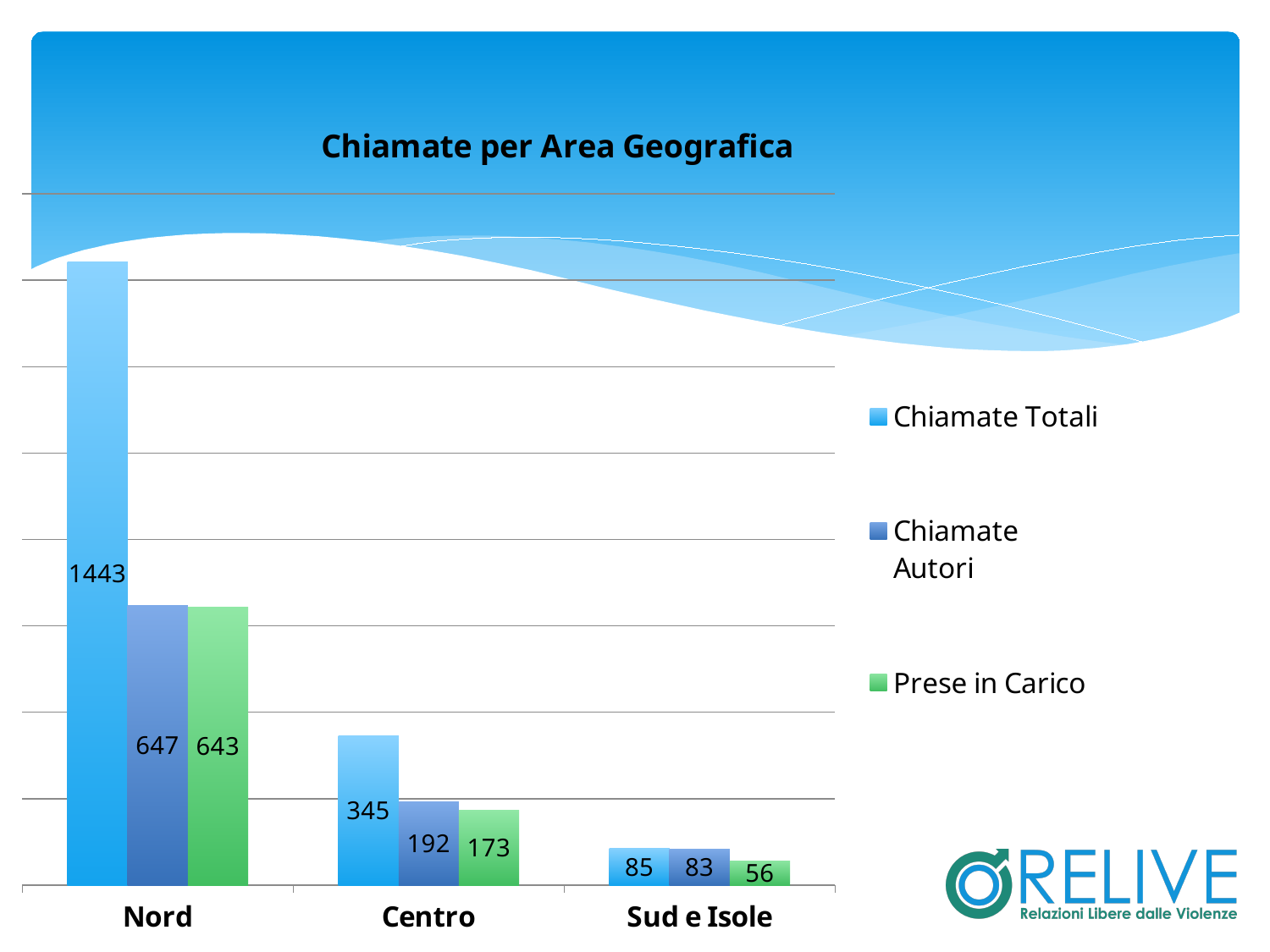
How many series does the legend list? 3 What is the value of Chiamate Totali for Nord? 1443 Which is larger for Nord: Chiamate Autori or Prese in Carico? Chiamate Autori What is the value of Chiamate Autori for Sud e Isole? 83 Do the Chiamate Totali values rise or fall from Nord to Sud e Isole? Fall What kind of chart is shown on the slide? Bar chart What is the value of Prese in Carico for Centro? 173 What is the difference between Chiamate Totali and Chiamate Autori for Centro? 153 Which area has the highest value for Chiamate Totali? Nord What is the title of the chart? Chiamate per Area Geografica Which area has the lowest value for Prese in Carico? Sud e Isole How many geographic areas are shown on the x axis? 3